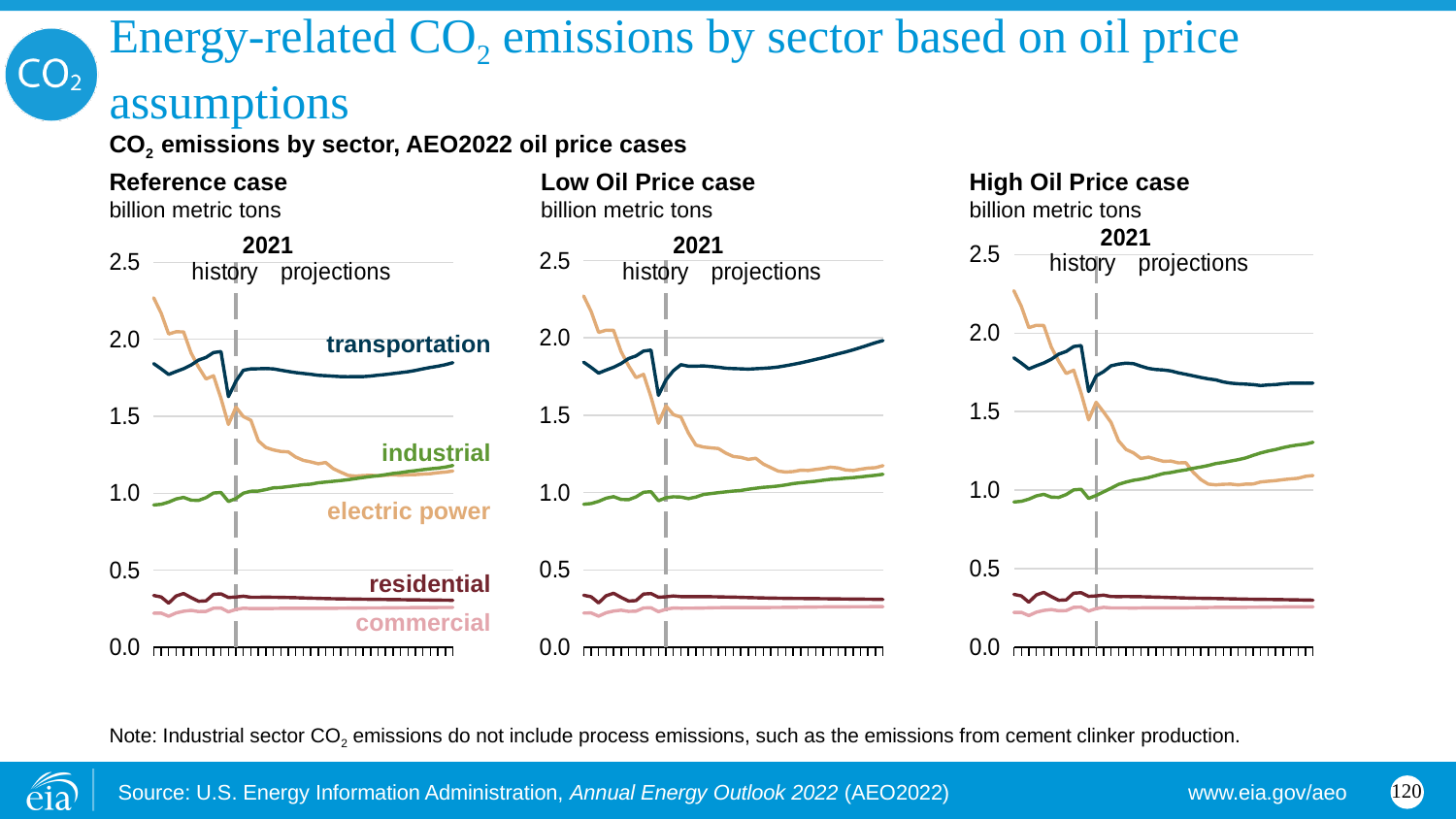
In the Reference case chart, which sector has the highest emissions at the end of the projection period? transportation In the High Oil Price case chart, is the value for electric power at the end of the projections greater or less than 1.5? less In the High Oil Price case chart, at the end of the projections, which is larger: industrial or electric power? industrial In the Reference case chart, is the value for transportation at the end of the projections greater or less than 1.5? greater How many charts are shown on the slide? 3 In the Reference case chart, which sector has the lowest emissions throughout the period? commercial In the Low Oil Price case chart, does transportation rise or fall over the projection period? rises In the High Oil Price case chart, does transportation rise or fall over the projection period? falls In the Reference case chart, how many sectors are plotted as lines? 5 What year marks the boundary between history and projections in the charts? 2021 In the Reference case chart, is the value for residential at the end of the projections greater or less than 0.5? less What kind of chart is used in the Reference case panel? line chart